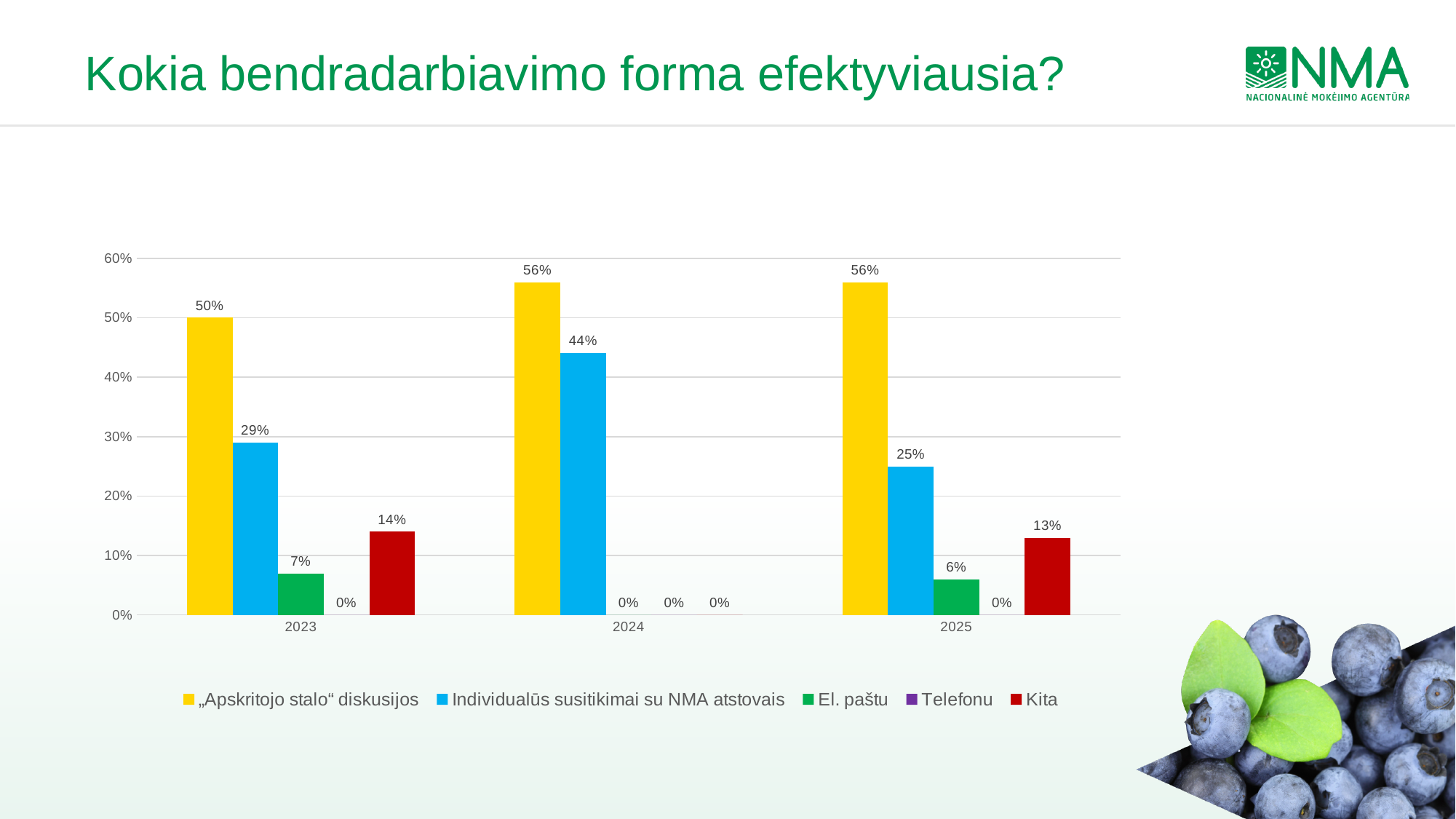
How many series does the legend list? 5 What is the value for Kita in 2025? 13% What is the value for Individualūs susitikimai su NMA atstovais in 2024? 44% Which is larger in 2023: Kita or El. paštu? Kita What kind of chart is shown on the slide? Bar chart Does the value for Individualūs susitikimai su NMA atstovais rise or fall from 2024 to 2025? Fall What is the difference between „Apskritojo stalo“ diskusijos and Individualūs susitikimai su NMA atstovais in 2025? 31% Which series has the highest value in 2024? „Apskritojo stalo“ diskusijos What is the value for El. paštu in 2023? 7% What colour represents Kita in the chart? Red How many year categories are shown on the x axis? 3 What is the value for „Apskritojo stalo“ diskusijos in 2023? 50%